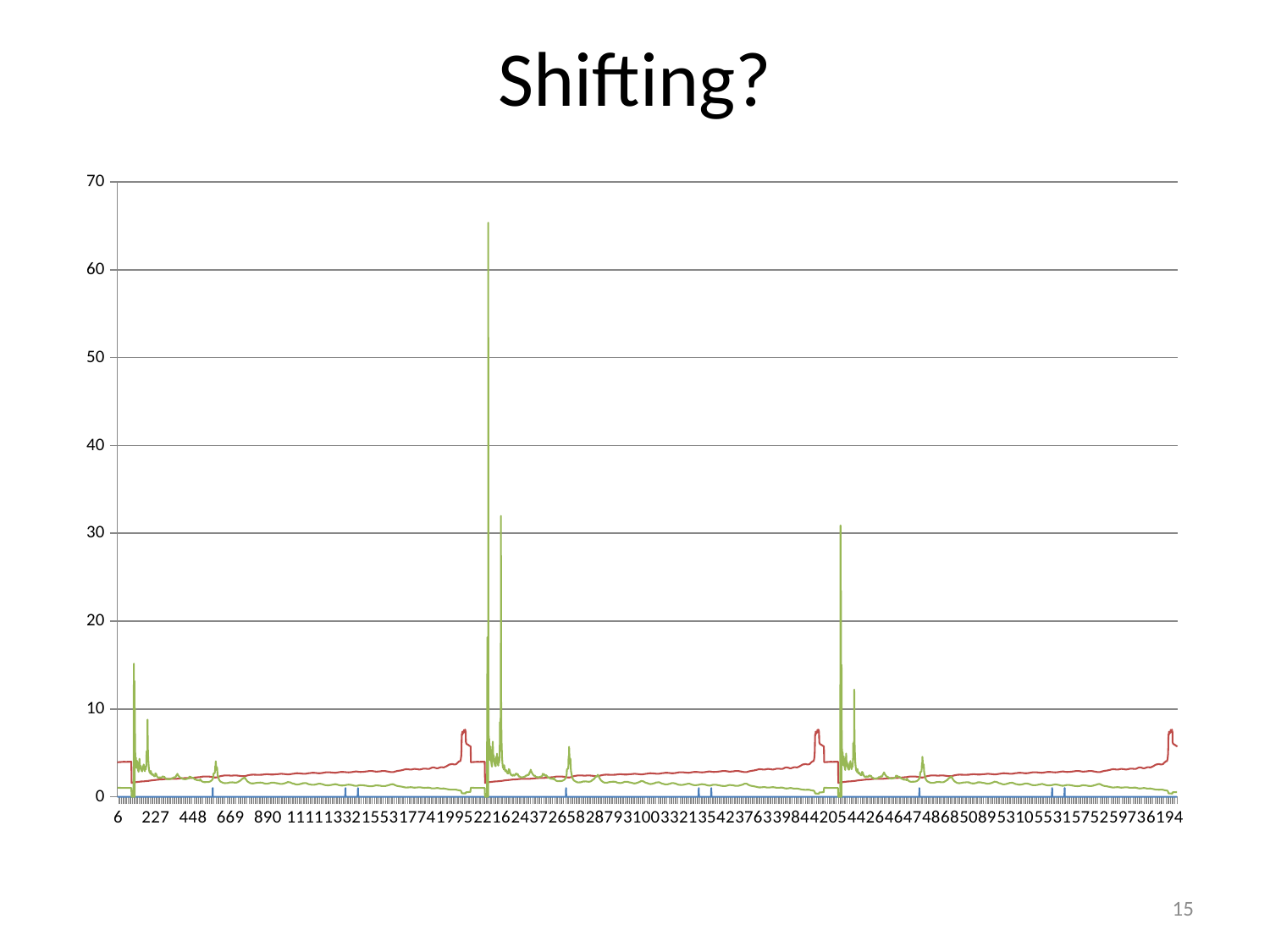
Is the highest value of the red line greater or less than 10? less Which line has the higher maximum value, the green line or the red line? green Is the green peak near the start of the x axis (between labels 6 and 227) greater or less than 20? less Which coloured line reaches the highest value on the chart? green Is the value of the red line at the far right end of the chart greater or less than 10? less What is the maximum value shown on the vertical axis? 70 What kind of chart is shown on the slide? line chart What is the first label on the horizontal axis? 6